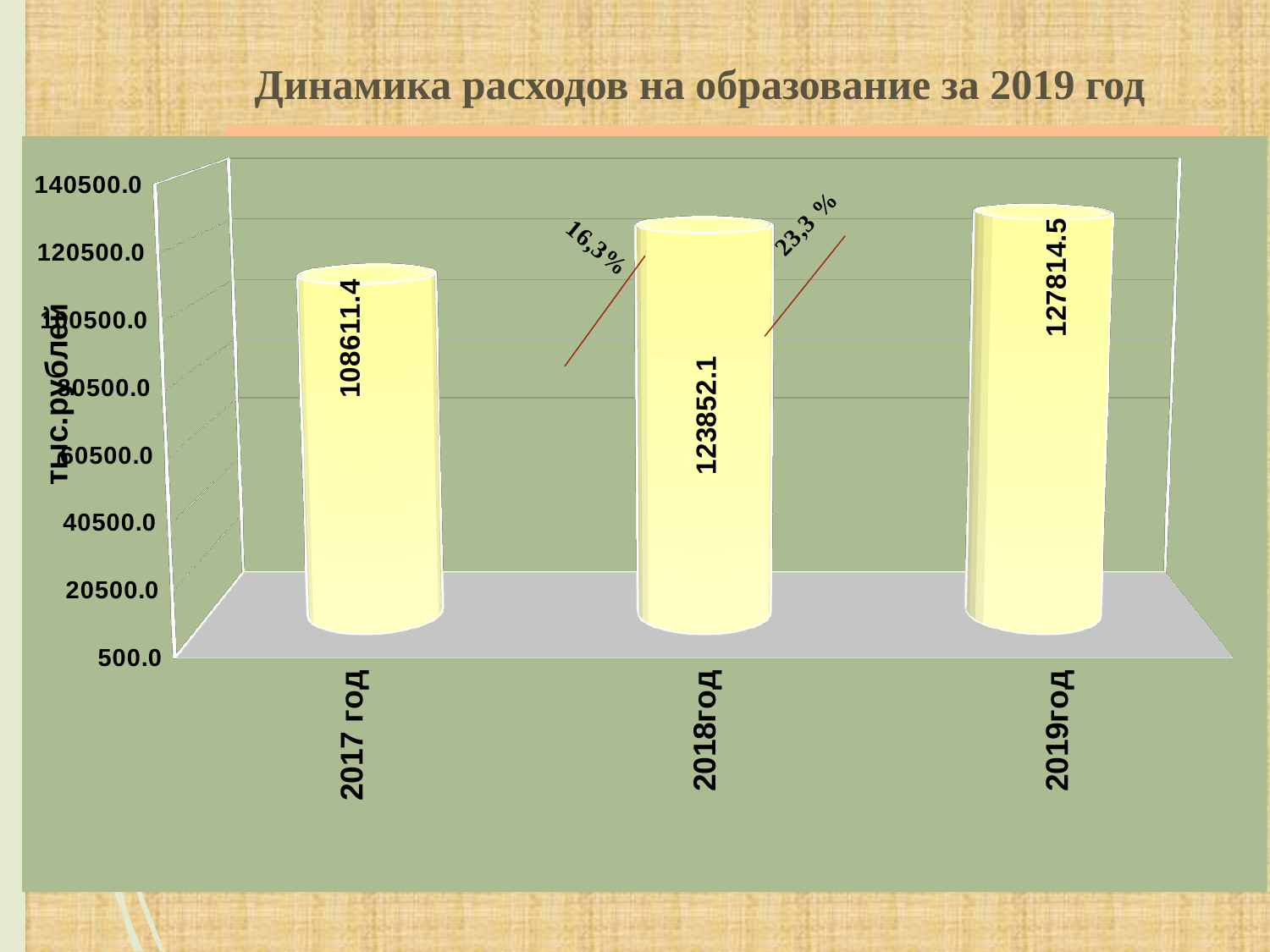
What is the value for 2018год? 123852.1 What is the difference between the values for 2018год and 2017 год? 15240.7 What is the value for 2019год? 127814.5 What kind of chart is shown on the slide? bar chart How many categories are shown on the chart? 3 Which year has the highest value? 2019год What is the value for 2017 год? 108611.4 What is the title of the chart? Динамика расходов на образование за 2019 год Do the values rise or fall from 2017 год to 2019год? rise What is the difference between the values for 2019год and 2018год? 3962.4 Which year has the lowest value? 2017 год Which is larger, the value for 2017 год or the value for 2018год? 2018год